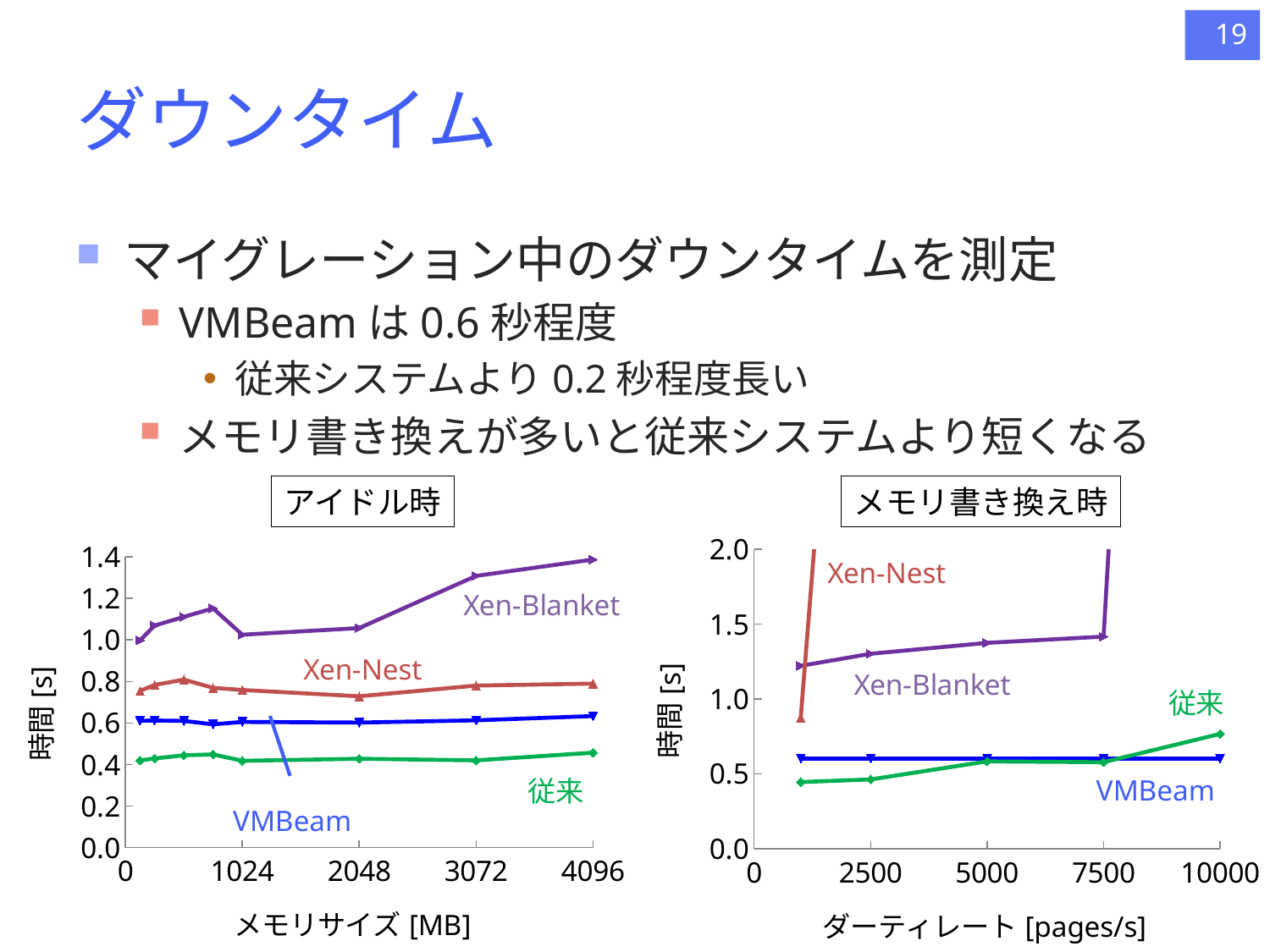
In the right chart (メモリ書き換え時), is the value for Xen-Blanket at 7500 pages/s greater or less than 1.0? greater In the left chart (アイドル時), how many series are plotted? 4 In the left chart (アイドル時), is the value for Xen-Blanket at 4096 MB greater or less than 1.2? greater In the right chart (メモリ書き換え時), does the 従来 line rise or fall as the dirty rate increases? rise What kind of chart is the left chart titled アイドル時? line chart In the left chart (アイドル時), which series has the lowest downtime across the memory sizes? 従来 In the right chart (メモリ書き換え時), which is larger at 10000 pages/s: 従来 or VMBeam? 従来 In the left chart (アイドル時), which series has the highest downtime across the memory sizes? Xen-Blanket In the left chart (アイドル時), is the value for Xen-Nest at 4096 MB greater or less than 1.0? less In the left chart (アイドル時), does the Xen-Blanket line generally rise or fall as memory size increases? rise In the left chart (アイドル時), which is larger at 4096 MB: VMBeam or 従来? VMBeam What is the x-axis label of the right chart (メモリ書き換え時)? ダーティレート [pages/s]